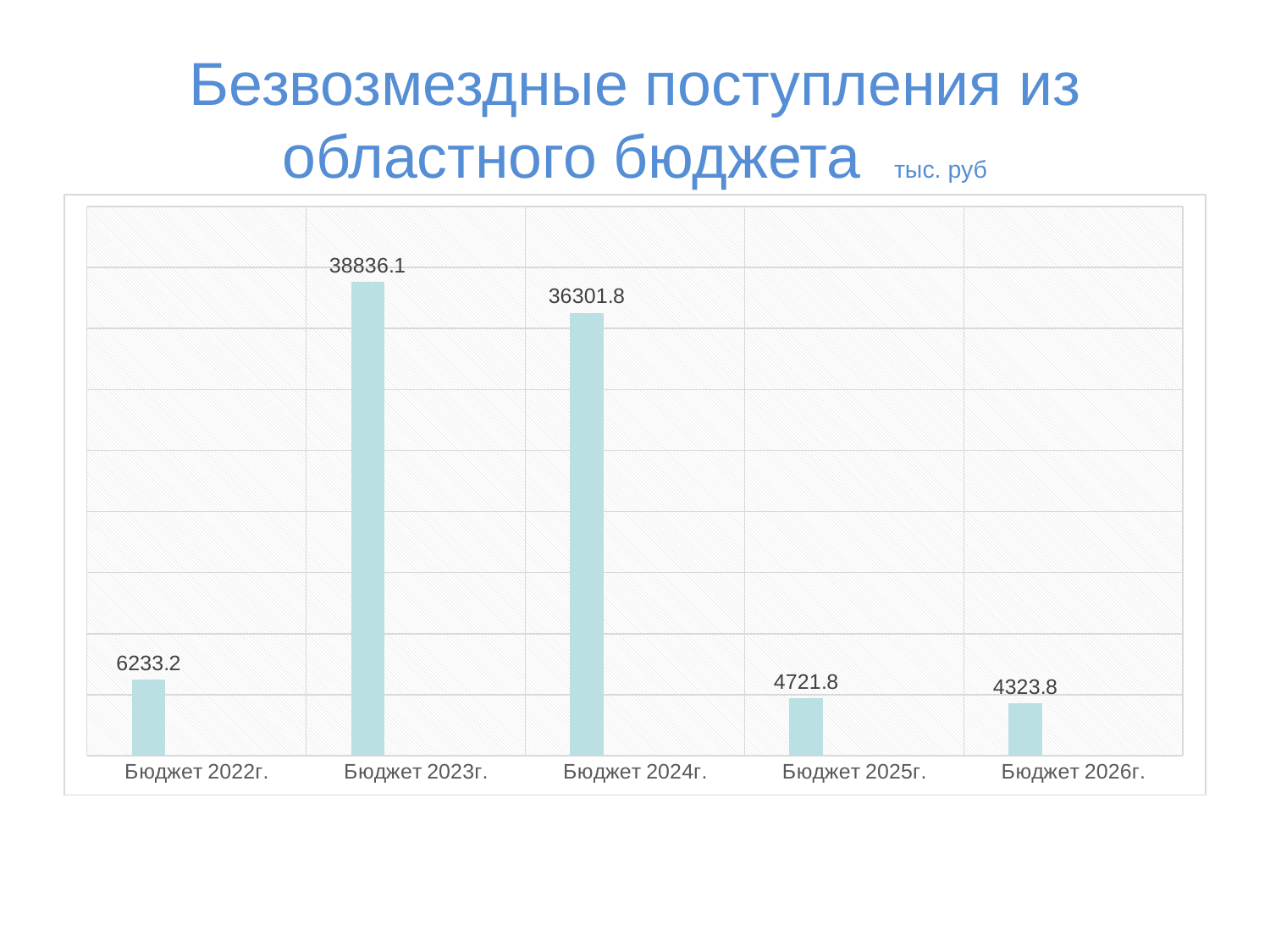
What is the value for Бюджет 2022г.? 6233.2 Which category has the lowest value? Бюджет 2026г. What is the value for Бюджет 2023г.? 38836.1 What is the difference between the values for Бюджет 2023г. and Бюджет 2024г.? 2534.3 Which category has the highest value? Бюджет 2023г. How many categories are shown on the x axis? 5 What is the difference between the values for Бюджет 2022г. and Бюджет 2025г.? 1511.4 What is the value for Бюджет 2026г.? 4323.8 What kind of chart is shown on the slide? Bar chart Which is larger, the value for Бюджет 2022г. or the value for Бюджет 2025г.? Бюджет 2022г. Do the values rise or fall from Бюджет 2024г. to Бюджет 2026г.? Fall What is the value for Бюджет 2025г.? 4721.8